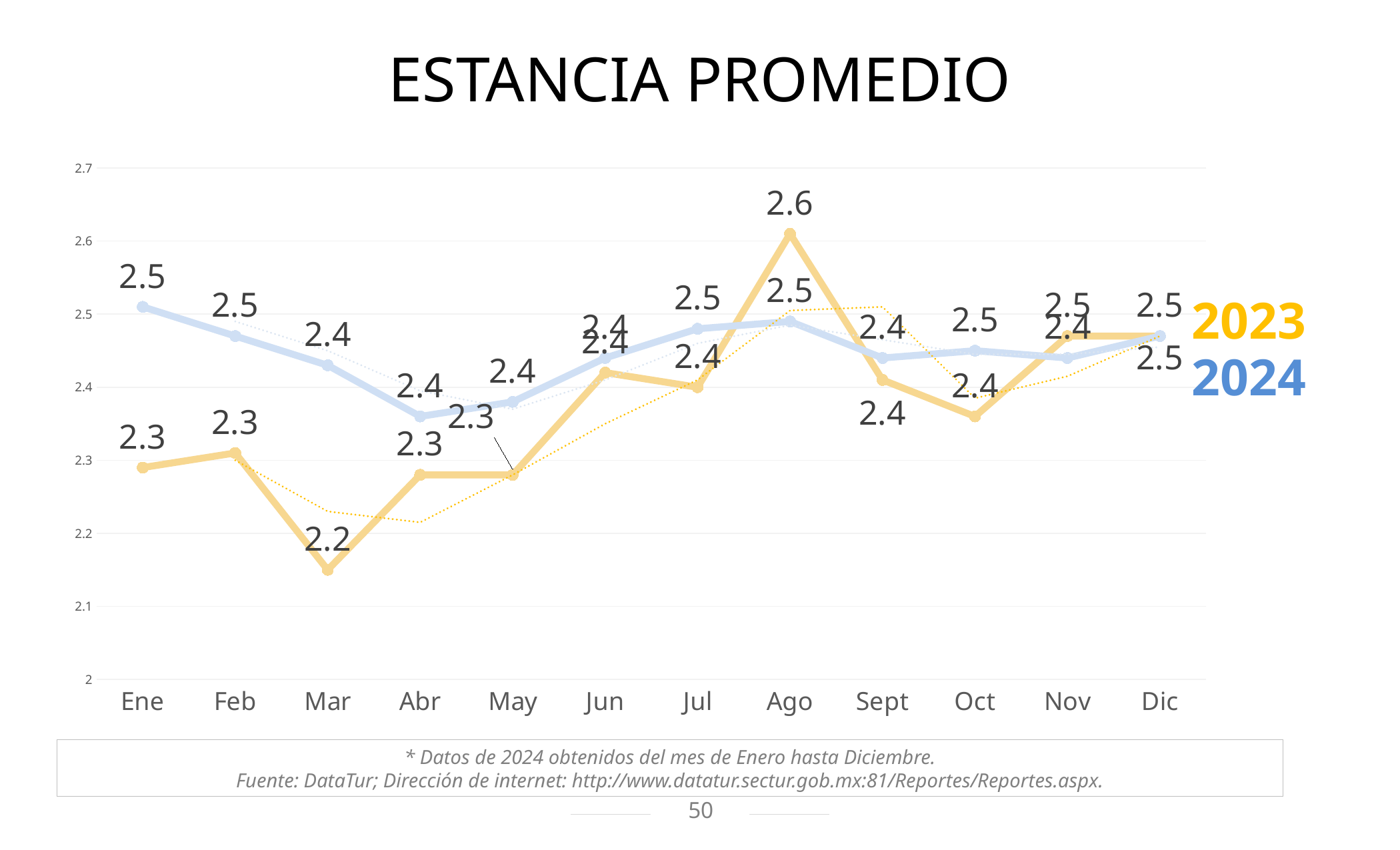
In Ene, which series has the larger value, 2023 or 2024? 2024 Is the 2023 value for Mar greater or less than 2.3? less How many months are plotted on the x axis? 12 What is the 2024 value for Ene? 2.5 What is the 2023 value for Ago? 2.6 What is the 2023 value for Mar? 2.2 What is the difference between the 2023 and 2024 values in Ago? 0.1 How many series does the chart show? 2 What kind of chart is shown on the slide? line chart In which month is the 2023 value highest? Ago What is the difference between the 2024 and 2023 values in Ene? 0.2 In which month is the 2023 value lowest? Mar